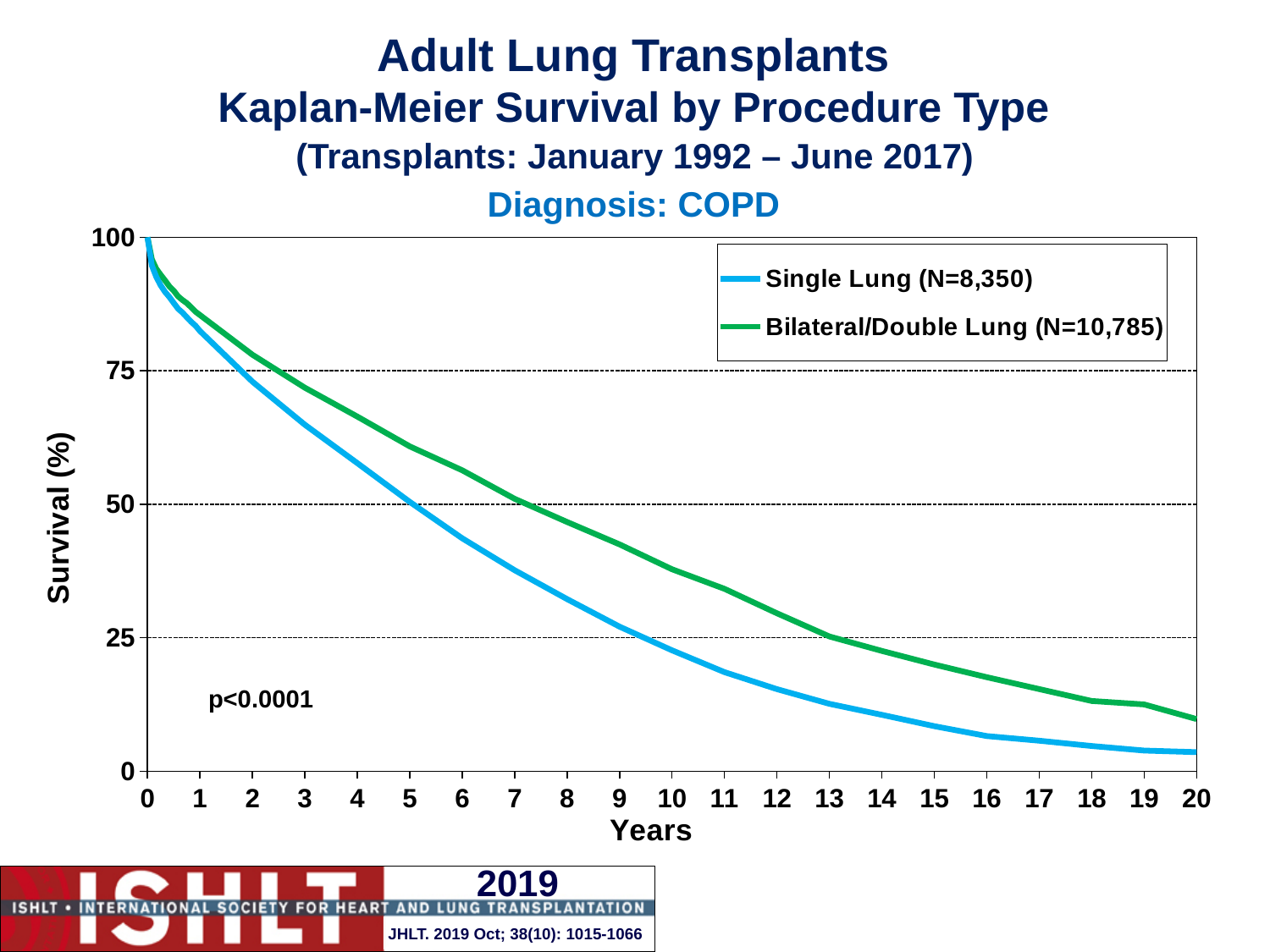
How many series does the legend list? 2 What kind of chart is shown on the slide? Line chart Is the survival for Single Lung at year 12 greater or less than 25? less Is the survival for Single Lung at year 3 greater or less than 75? less Which series has the lower survival at year 15? Single Lung What p-value is printed on the chart? p<0.0001 Is the survival for Bilateral/Double Lung at year 5 greater or less than 50? greater Do the survival curves rise or fall as years increase? Fall Which series has the higher survival at year 10, Single Lung or Bilateral/Double Lung? Bilateral/Double Lung What is the N for the Single Lung group shown in the legend? 8,350